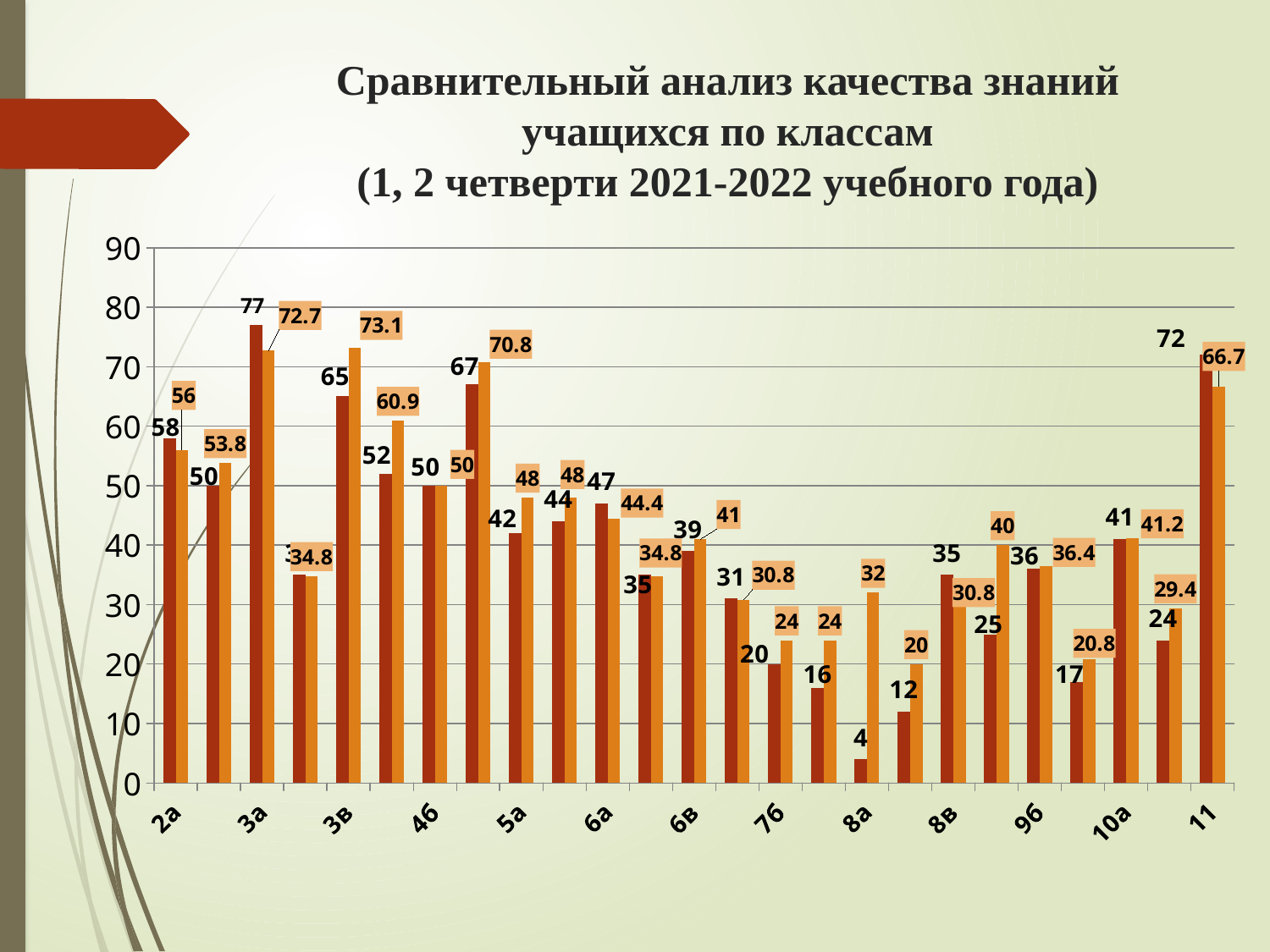
For class 3в, which bar is larger, the dark red one or the orange one? the orange one What is the difference between the dark red bar and the orange bar for class 11? 5.3 What is the difference between the orange bar and the dark red bar for class 8а? 28 What is the value of the dark red bar for class 8а? 4 Which class has the highest value of any bar in the chart? 3а What is the value of the dark red bar for class 3а? 77 What is the value of the orange bar for class 11? 66.7 Which class has the lowest value of any bar in the chart? 8а Is the value of the orange bar for class 8а greater or less than 30? greater What is the value of the orange bar for class 3в? 73.1 How many class labels are shown on the x axis? 13 What type of chart is shown on the slide? bar chart